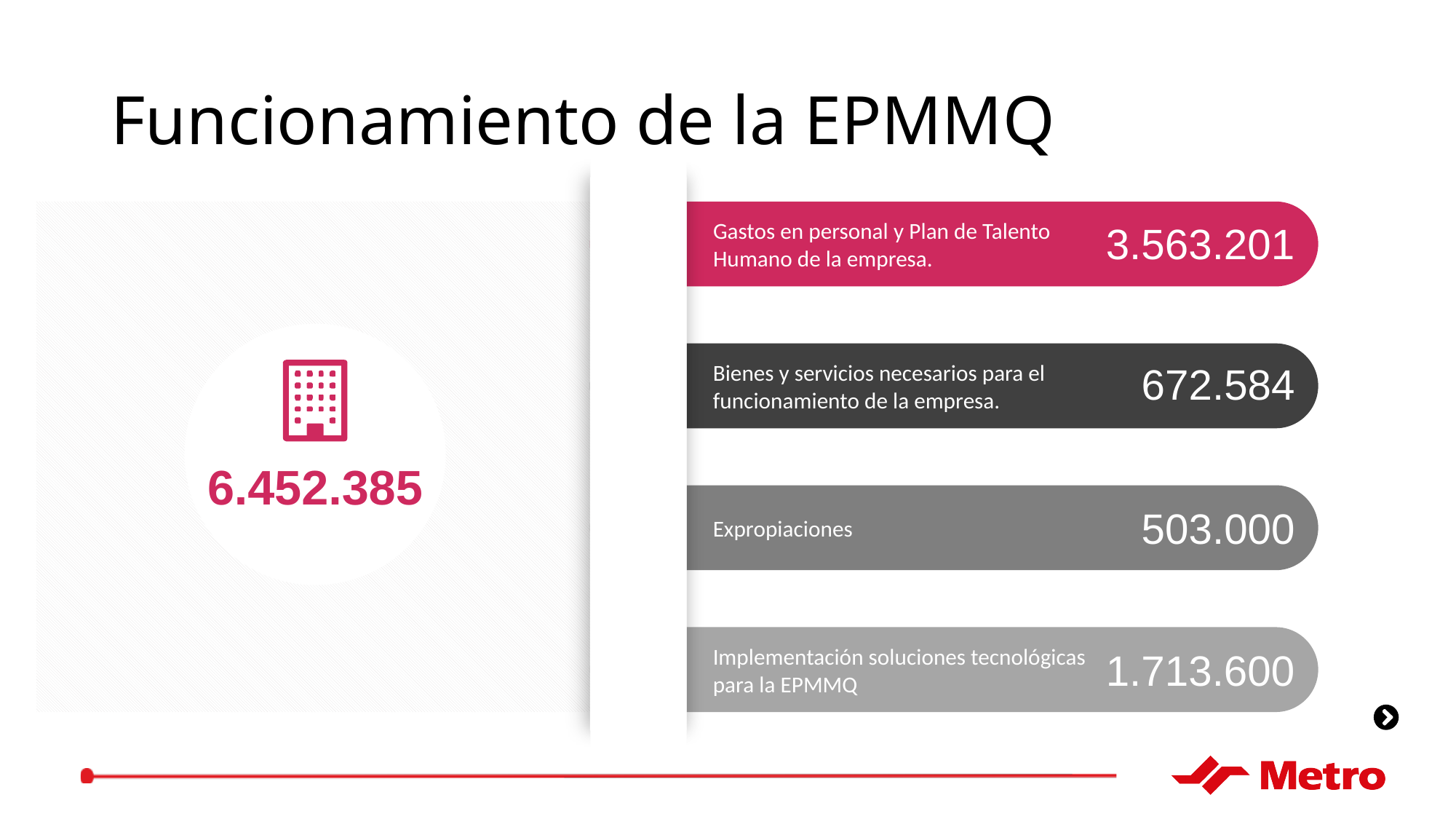
What is the title of the slide? Funcionamiento de la EPMMQ What is the value shown for "Bienes y servicios necesarios para el funcionamiento de la empresa"? 672.584 What is the value shown for "Expropiaciones"? 503.000 What is the difference between the value for "Gastos en personal y Plan de Talento Humano de la empresa" and the value for "Implementación soluciones tecnológicas para la EPMMQ"? 1.849.601 What is the value shown for "Implementación soluciones tecnológicas para la EPMMQ"? 1.713.600 What is the difference between the value for "Bienes y servicios necesarios para el funcionamiento de la empresa" and the value for "Expropiaciones"? 169.584 Which is larger: the value for "Implementación soluciones tecnológicas para la EPMMQ" or the value for "Bienes y servicios necesarios para el funcionamiento de la empresa"? Implementación soluciones tecnológicas para la EPMMQ What is the value shown for "Gastos en personal y Plan de Talento Humano de la empresa"? 3.563.201 What total figure is shown in the circle on the left of the slide? 6.452.385 Which item has the lowest value? Expropiaciones Which item has the highest value? Gastos en personal y Plan de Talento Humano de la empresa How many expense items are listed on the right side of the slide? 4